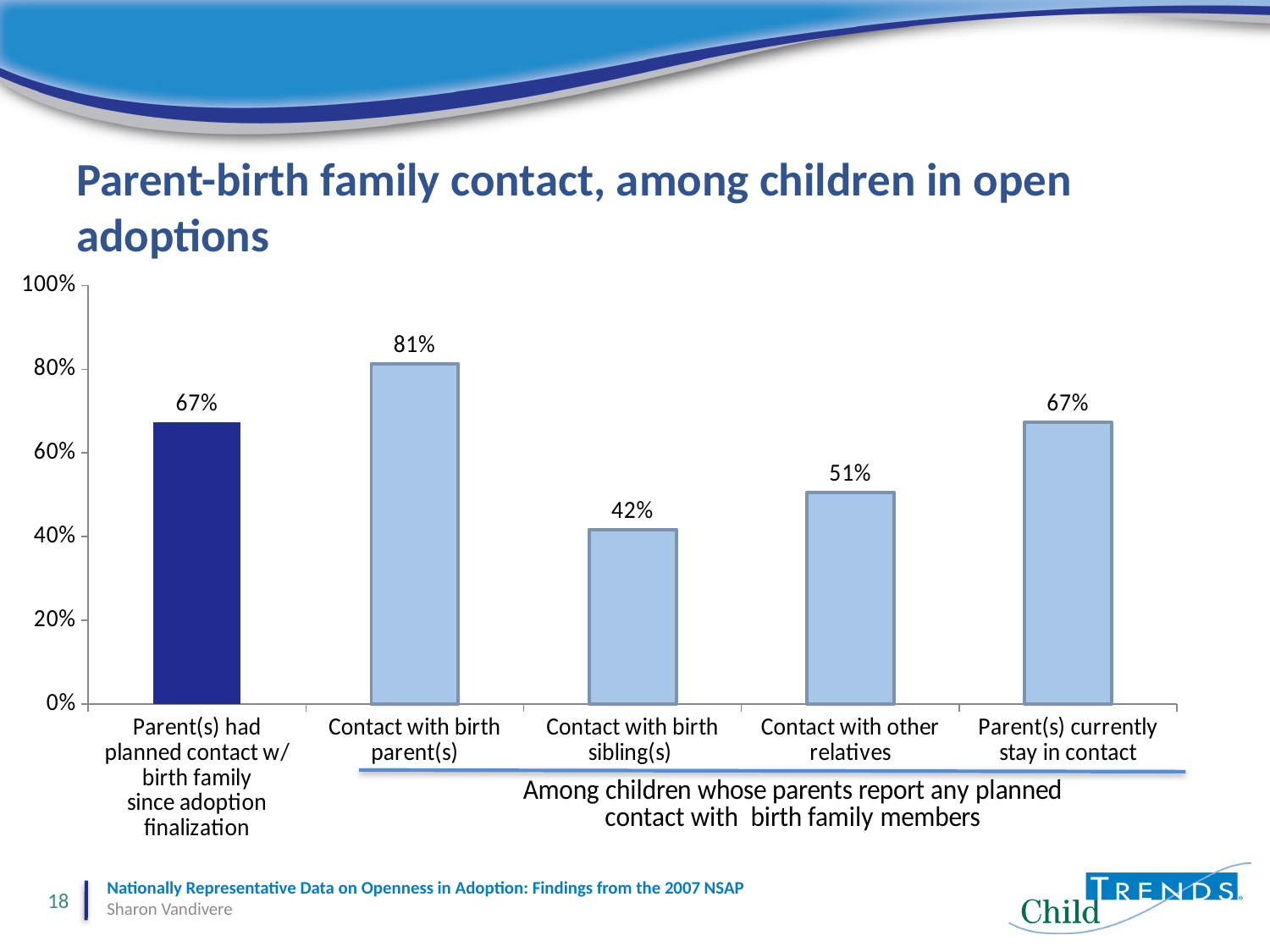
Is the value for "Contact with other relatives" greater or less than 60%? less What is the value for "Contact with birth sibling(s)"? 42% Which is larger: the value for "Contact with other relatives" or the value for "Parent(s) currently stay in contact"? Parent(s) currently stay in contact What kind of chart is shown on the slide? Bar chart What is the title of the chart? Parent-birth family contact, among children in open adoptions Which category has the lowest value? Contact with birth sibling(s) What is the value for "Parent(s) currently stay in contact"? 67% How many categories are shown in the chart? 5 What is the difference between the values for "Contact with birth parent(s)" and "Contact with birth sibling(s)"? 39% Which category has the highest value? Contact with birth parent(s) What is the value for "Contact with birth parent(s)"? 81% What is the value for "Contact with other relatives"? 51%